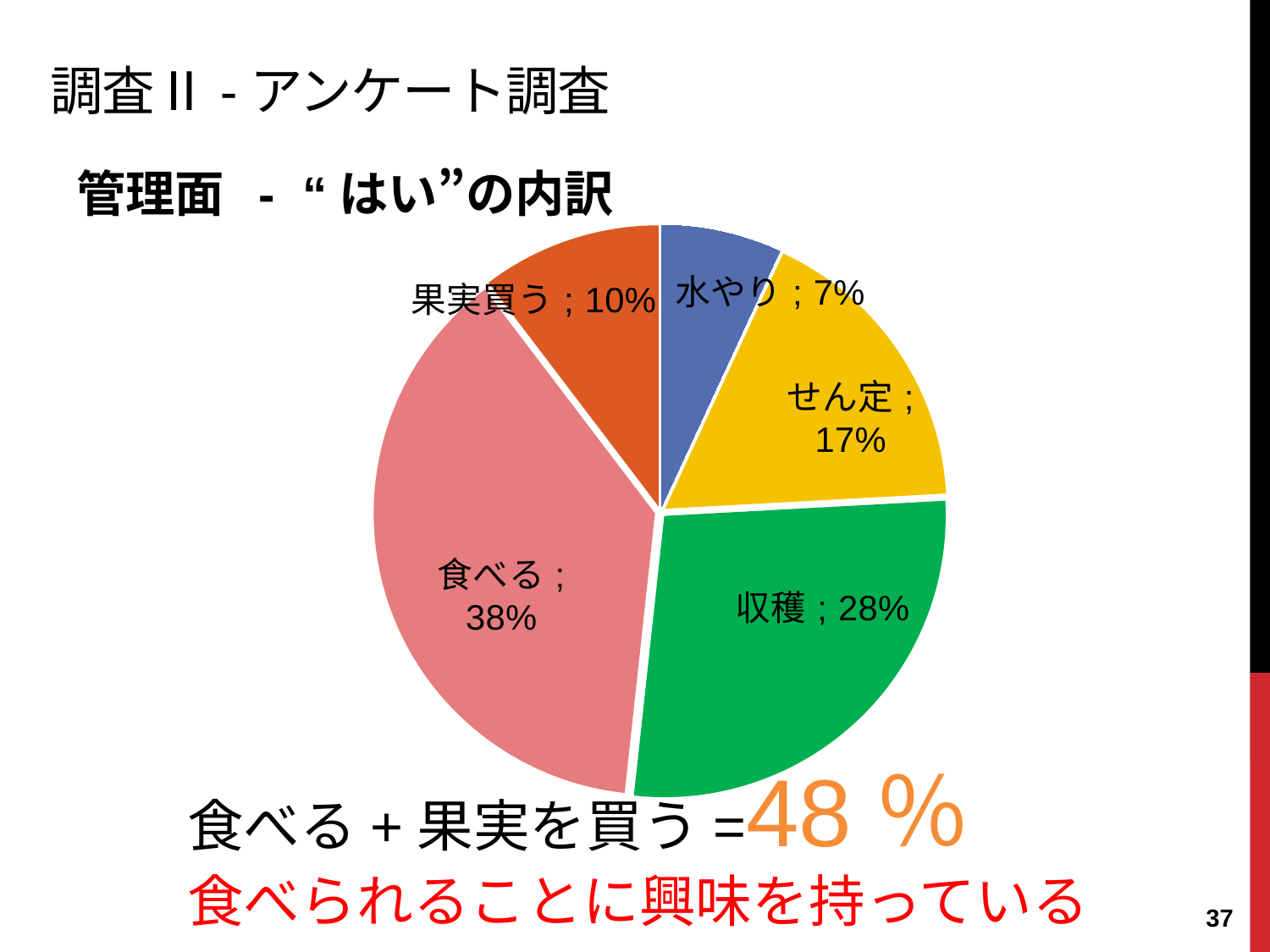
What percentage is shown for 水やり? 7% Which is larger, the slice for せん定 or the slice for 果実買う? せん定 What is the value labelled for せん定? 17% What share of the pie does 食べる account for? 38% What colour is the 収穫 slice? Green How many slices does the pie chart have? 5 What is the difference in percentage points between 食べる and 収穫? 10 Which category has the smallest slice of the pie? 水やり What percentage is shown for 収穫? 28% Which category has the largest slice of the pie? 食べる What kind of chart is shown on the slide? Pie chart What is the combined share of 食べる and 果実買う? 48%